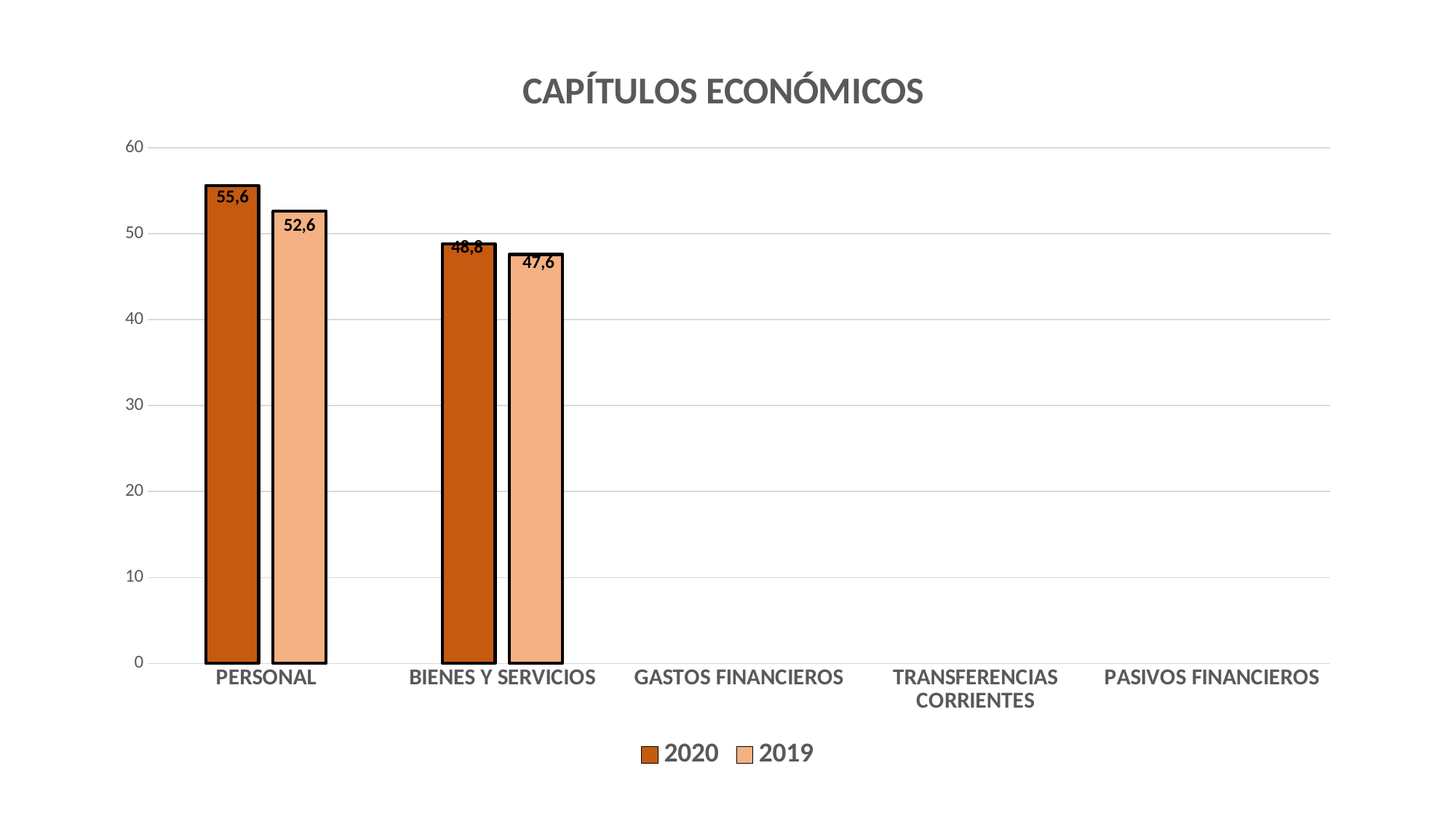
Which category has the highest 2020 value? PERSONAL What is the difference between the 2020 values for PERSONAL and BIENES Y SERVICIOS? 6,8 How many categories are shown on the x axis? 5 What is the 2019 value for BIENES Y SERVICIOS? 47,6 What kind of chart is shown? bar chart What is the 2019 value for PERSONAL? 52,6 Is the 2020 value for BIENES Y SERVICIOS greater or less than 50? less What is the 2020 value for BIENES Y SERVICIOS? 48,8 How many series does the legend list? 2 What is the difference between the 2020 and 2019 values for PERSONAL? 3 Which is larger: the 2019 value for PERSONAL or the 2019 value for BIENES Y SERVICIOS? PERSONAL What is the 2020 value for PERSONAL? 55,6